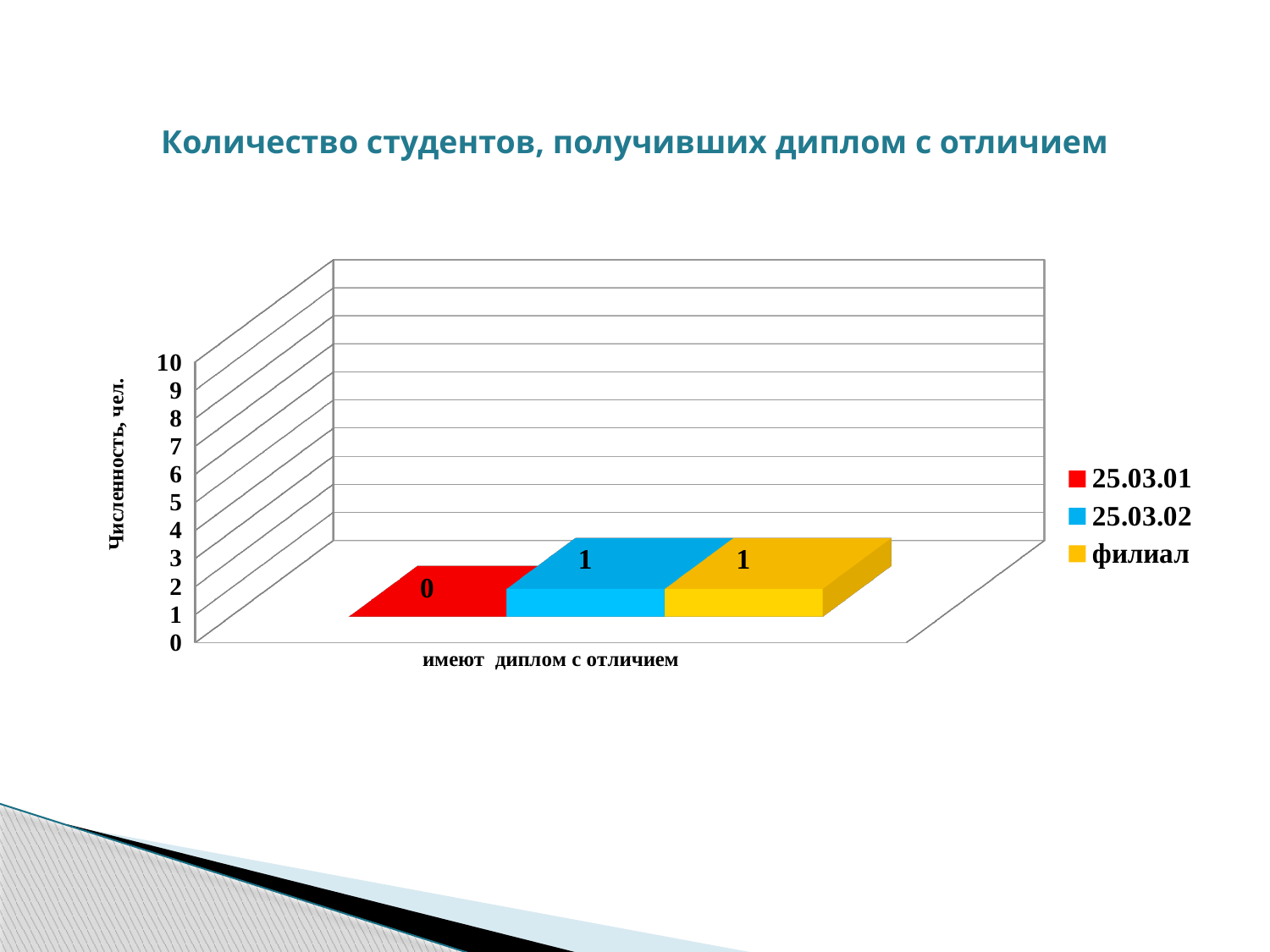
What kind of chart is shown on the slide? bar chart What is the category label on the horizontal axis? имеют диплом с отличием Which series has the lowest value in the chart? 25.03.01 Is the value for филиал greater or less than 5? less What is the value for 25.03.02 in the chart? 1 How many series does the legend list? 3 What is the label of the vertical axis? Численность, чел. What is the difference between the values for 25.03.02 and 25.03.01? 1 What is the title of the chart on the slide? Количество студентов, получивших диплом с отличием Which is larger, the value for 25.03.02 or the value for 25.03.01? 25.03.02 What is the value for филиал in the chart? 1 What is the value for 25.03.01 in the chart? 0